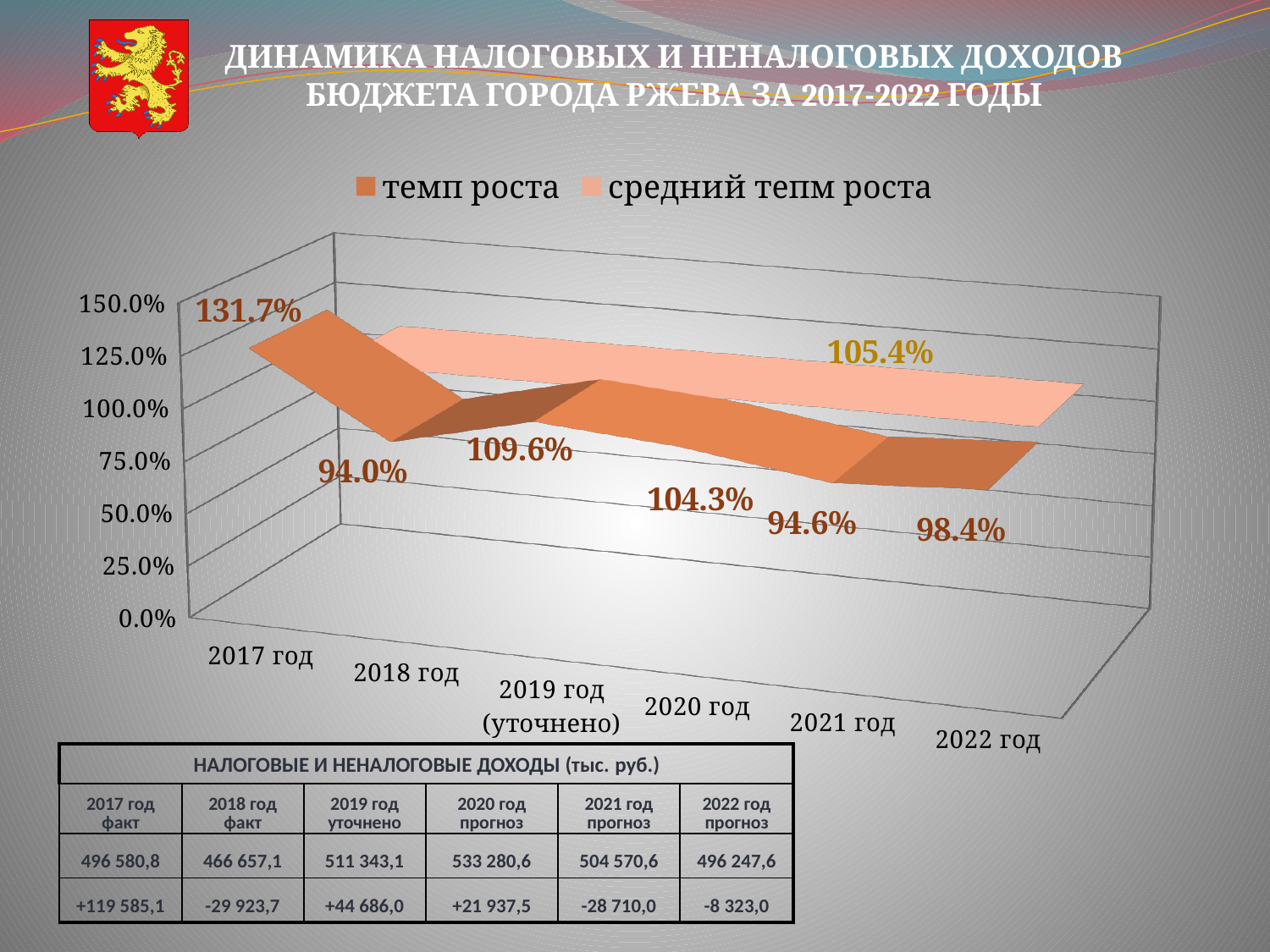
Is the value of темп роста for 2018 год greater or less than 100.0%? less What is the value of темп роста for 2022 год? 98.4% Which year has the highest темп роста? 2017 год What is the value of темп роста for 2019 год (уточнено)? 109.6% Which is larger, темп роста for 2020 год or for 2021 год? 2020 год How many series does the chart legend list? 2 What value is labelled for the средний тепм роста series? 105.4% Which year has the lowest темп роста? 2018 год What is the difference between темп роста in 2017 год and 2018 год? 37.7 percentage points What kind of chart is shown on the slide? 3D line chart How many years are shown on the x axis of the chart? 6 What is the value of темп роста for 2017 год? 131.7%